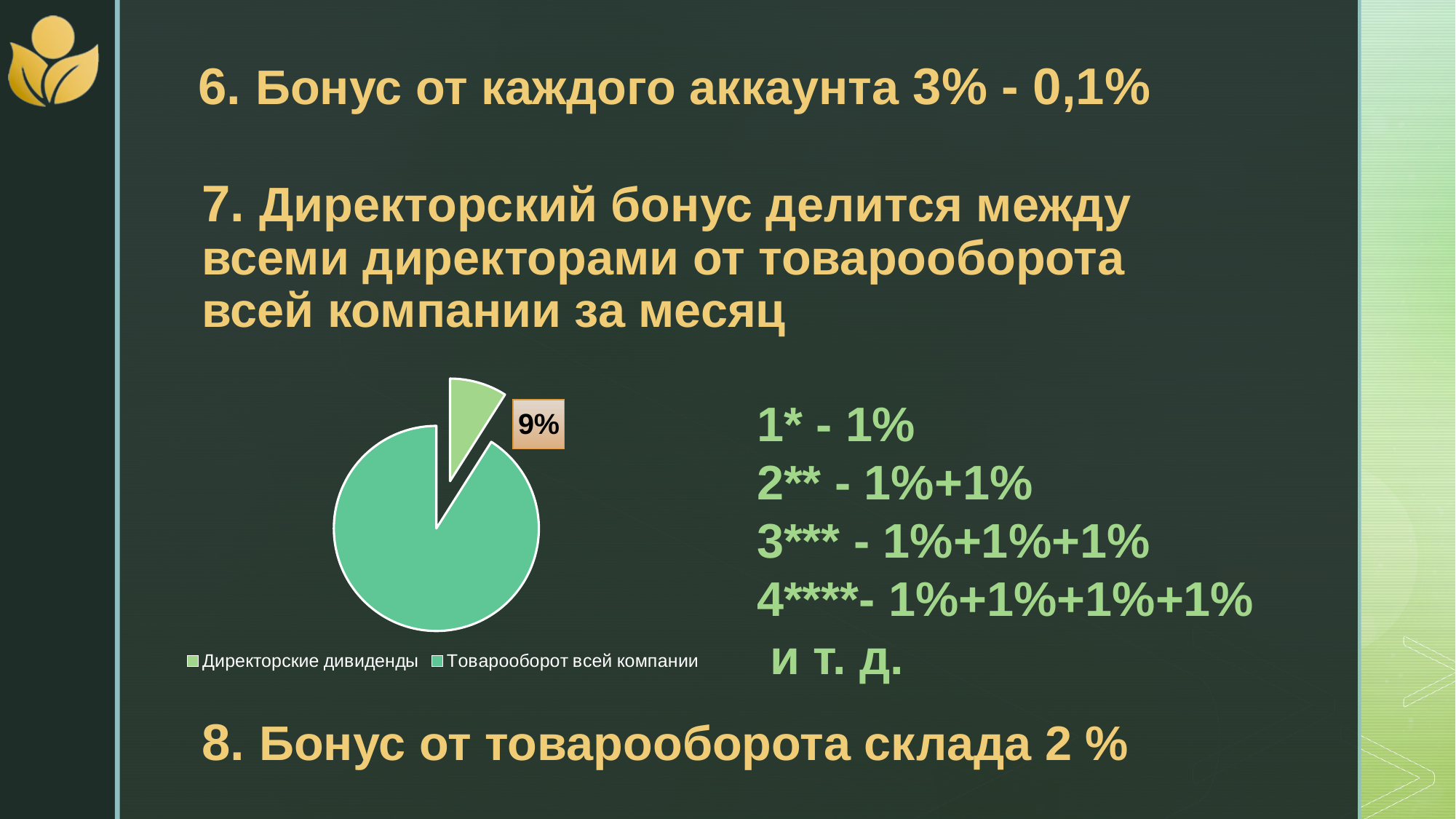
Which slice of the pie chart is the largest? Товарооборот всей компании What share of the pie does the "Директорские дивиденды" slice represent? 9% Which slice of the pie chart is the smallest? Директорские дивиденды Which legend entry in the pie chart is shown in light green? Директорские дивиденды Which is larger in the pie chart: "Директорские дивиденды" or "Товарооборот всей компании"? Товарооборот всей компании How many slices does the pie chart have? 2 What percentage is shown for the slice "Директорские дивиденды" in the pie chart? 9% Which slice of the pie chart is pulled out (exploded) from the rest of the pie? Директорские дивиденды What kind of chart is shown on the slide? pie chart Is the share of "Товарооборот всей компании" in the pie chart greater or less than 50%? greater Is the share of "Директорские дивиденды" in the pie chart greater or less than 50%? less How many entries does the legend of the pie chart list? 2